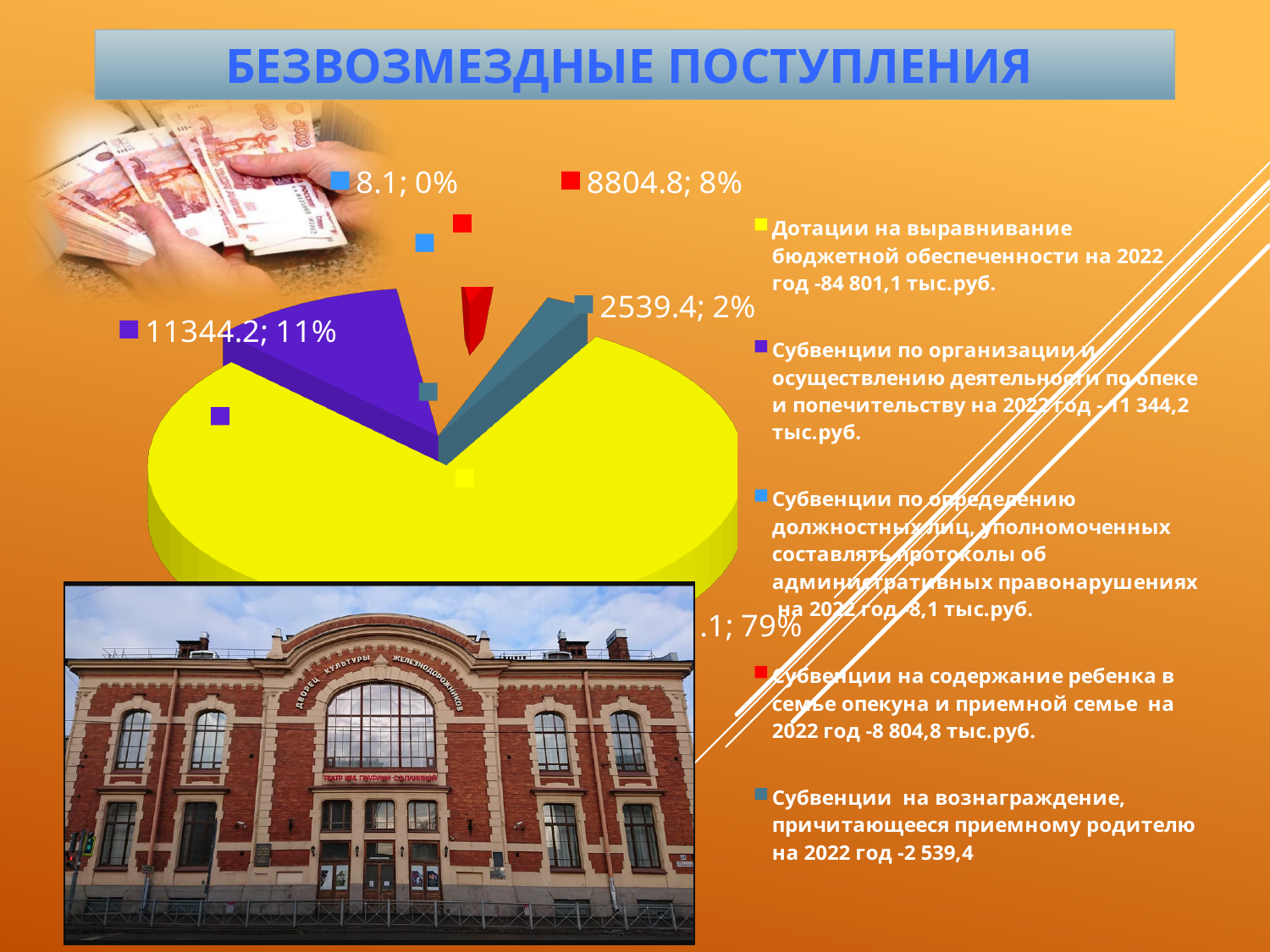
What value is labelled on the red slice of the pie chart? 8804.8 What share of the pie does the slice labelled 8.1 represent? 0% How many slices does the pie chart have? 5 Which slice of the pie chart is the smallest? 8.1; 0% What kind of chart is shown on the slide? pie chart What share of the pie does the slice labelled 2539.4 represent? 2% What share of the pie does the red slice (8804.8) represent? 8% What is the difference between the values of the purple slice (11344.2) and the red slice (8804.8)? 2539.4 What is the title of the slide containing the pie chart? БЕЗВОЗМЕЗДНЫЕ ПОСТУПЛЕНИЯ What value is labelled on the purple slice of the pie chart? 11344.2 What share of the pie does the largest (yellow) slice represent? 79%